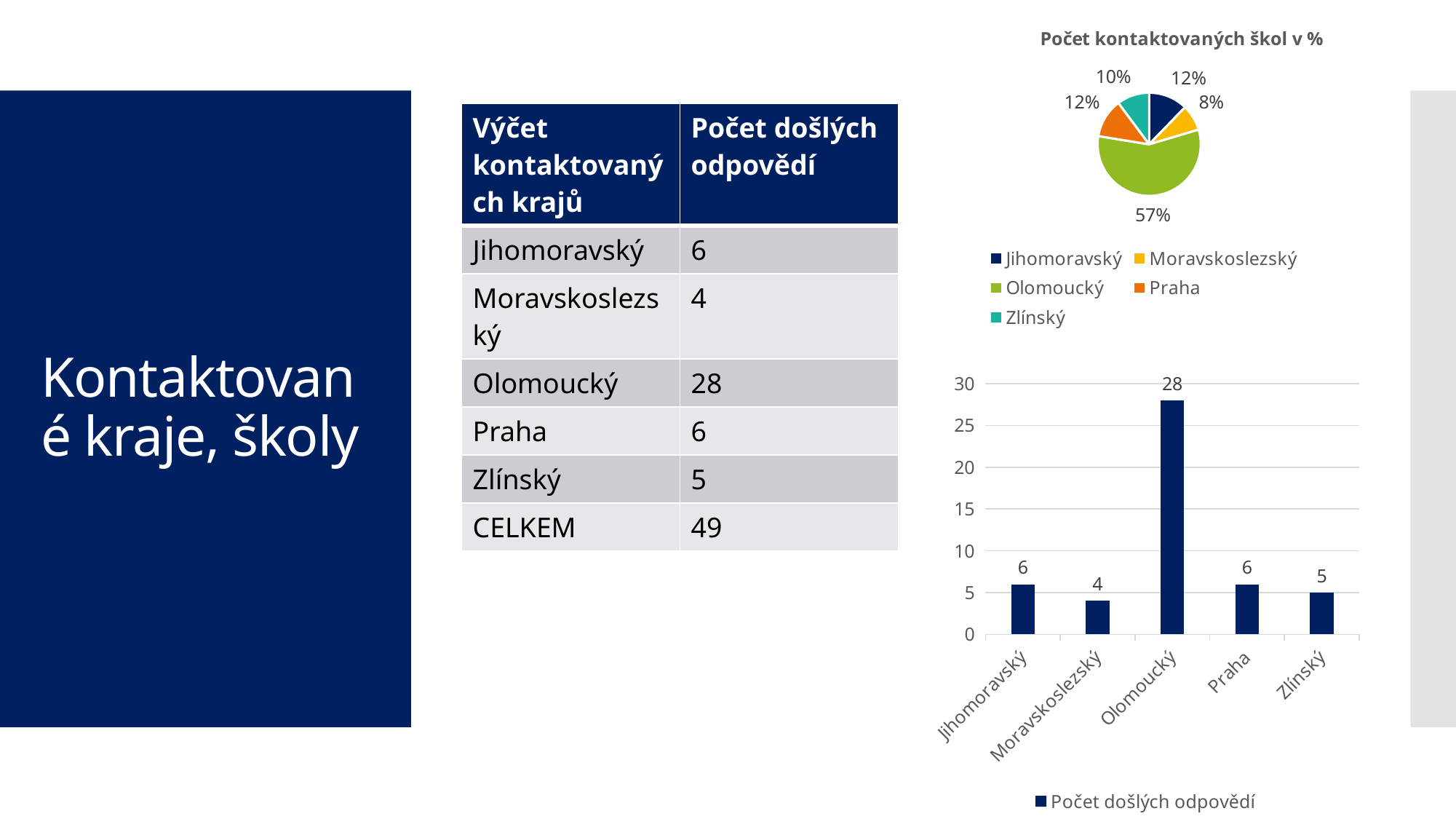
What is the legend entry of the bar chart at the bottom right? Počet došlých odpovědí In the bar chart at the bottom right, what is the difference between the values for Olomoucký and Praha? 22 In the pie chart 'Počet kontaktovaných škol v %', what share does Zlínský have? 10% In the pie chart 'Počet kontaktovaných škol v %', what share does Olomoucký have? 57% How many entries does the legend of the pie chart 'Počet kontaktovaných škol v %' list? 5 What kind of chart is the chart at the bottom right of the slide? bar chart In the bar chart at the bottom right, what is the value for Olomoucký? 28 In the bar chart at the bottom right, which is larger, the value for Zlínský or the value for Moravskoslezský? Zlínský How many categories are shown in the bar chart at the bottom right? 5 In the bar chart at the bottom right, which category has the highest value? Olomoucký In the bar chart at the bottom right, which category has the lowest value? Moravskoslezský In the bar chart at the bottom right, what is the value for Moravskoslezský? 4